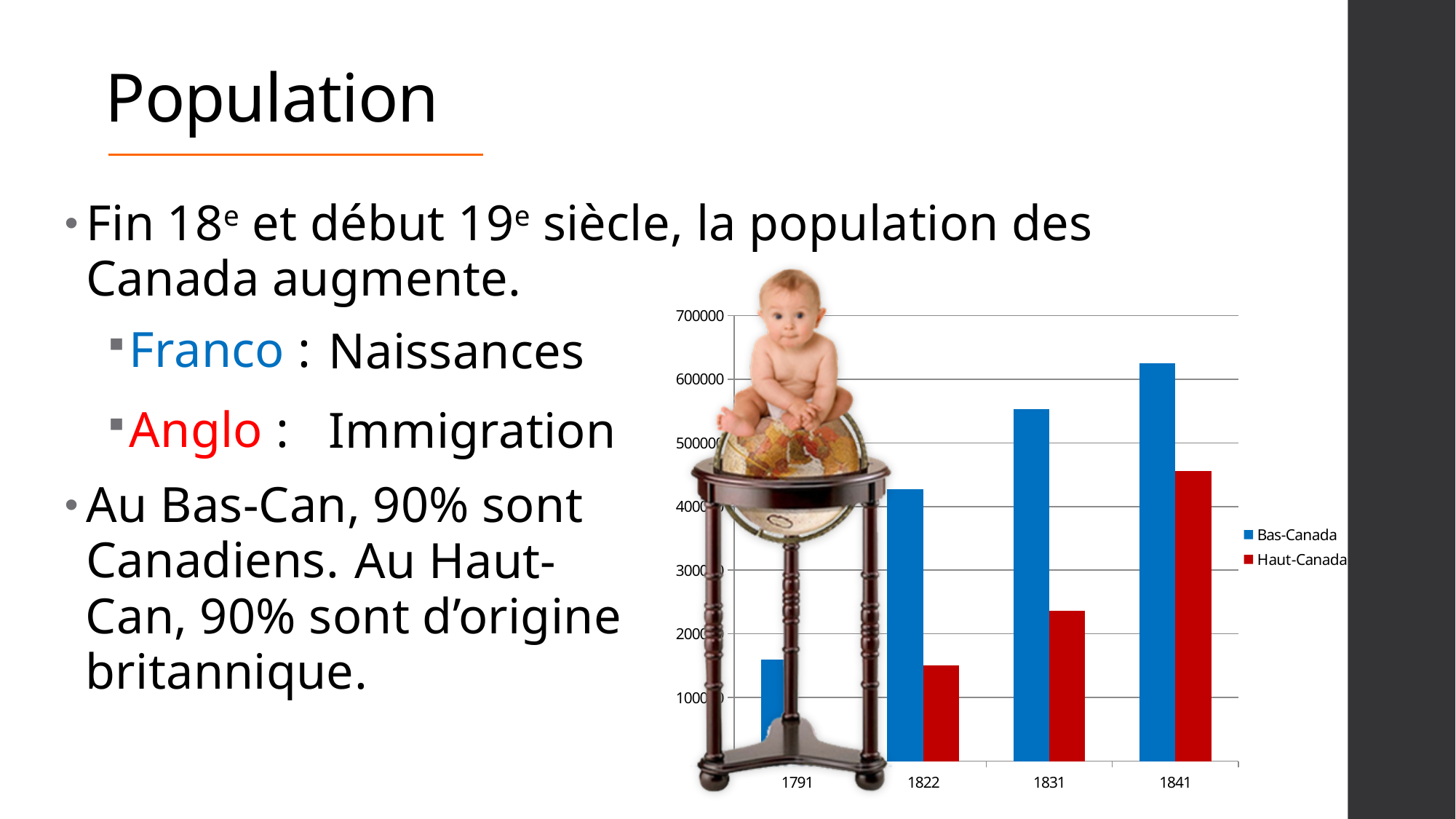
In which year is the Bas-Canada bar the lowest? 1791 What kind of chart is shown on the slide? bar chart In which year is the Bas-Canada bar the highest? 1841 Which colour represents Haut-Canada in the chart's legend? red In 1841, which is larger: the Bas-Canada value or the Haut-Canada value? Bas-Canada Is the value for Haut-Canada in 1841 greater or less than 400000? greater Do the Bas-Canada values rise or fall from 1791 to 1841? rise How many series does the chart's legend list? 2 Is the value for Haut-Canada in 1822 greater or less than 200000? less How many years are shown along the x axis of the chart? 4 In which year is the Haut-Canada bar the highest? 1841 Is the value for Bas-Canada in 1841 greater or less than 600000? greater